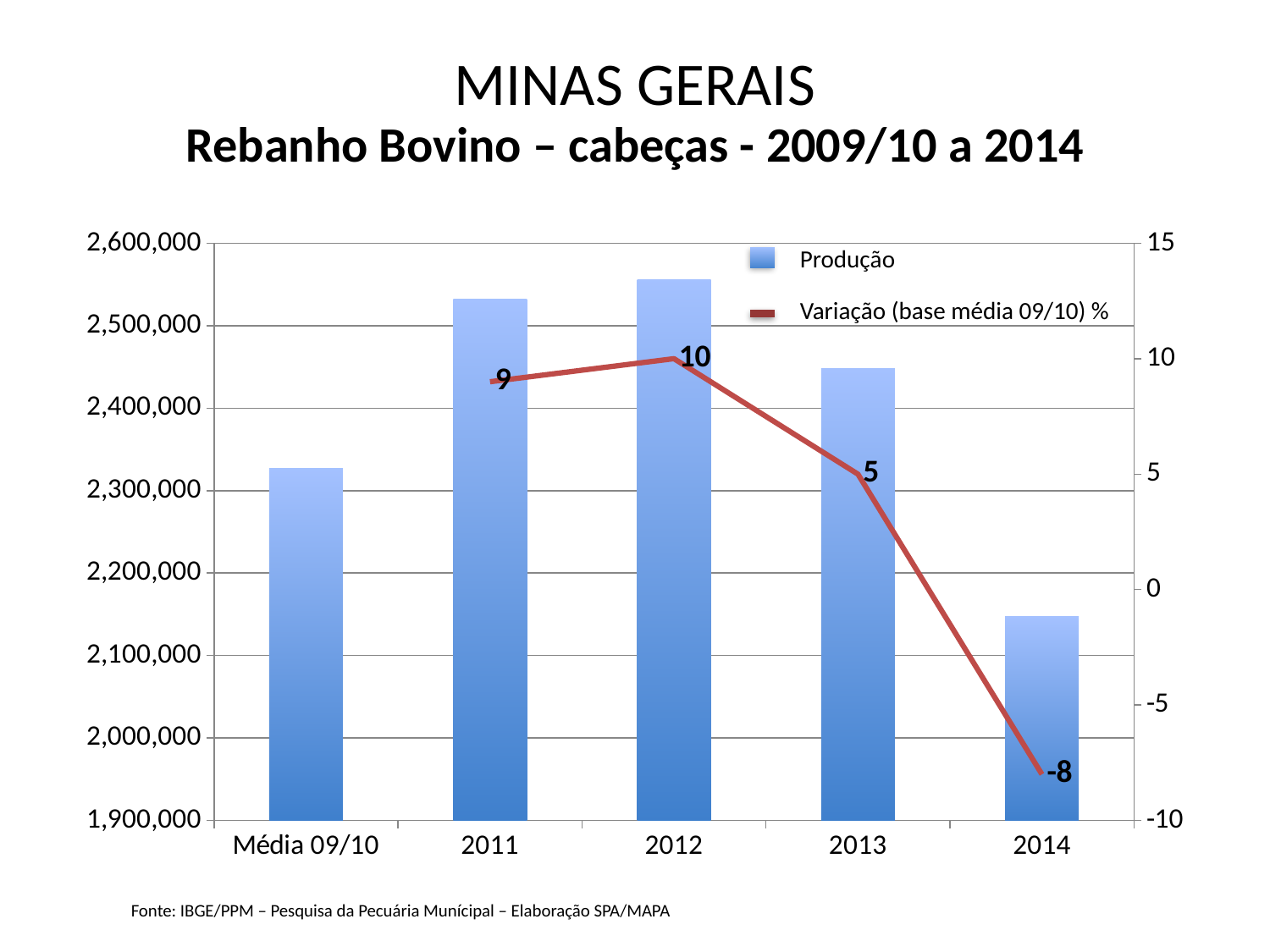
What is the Variação (base média 09/10) % value for 2012? 10 Which has a taller Produção bar, 2012 or 2014? 2012 What is the Variação (base média 09/10) % value for 2011? 9 How many categories are shown on the x axis? 5 Does the Variação line rise or fall from 2012 to 2014? fall What is the Variação (base média 09/10) % value for 2014? -8 How many series does the legend list? 2 Is the Produção value for 2011 greater or less than 2,500,000? greater Is the Produção value for 2014 greater or less than 2,200,000? less What is the difference between the Variação values for 2013 and 2014? 13 Which year has the highest Variação (base média 09/10) % value? 2012 Which year has the lowest Variação (base média 09/10) % value? 2014